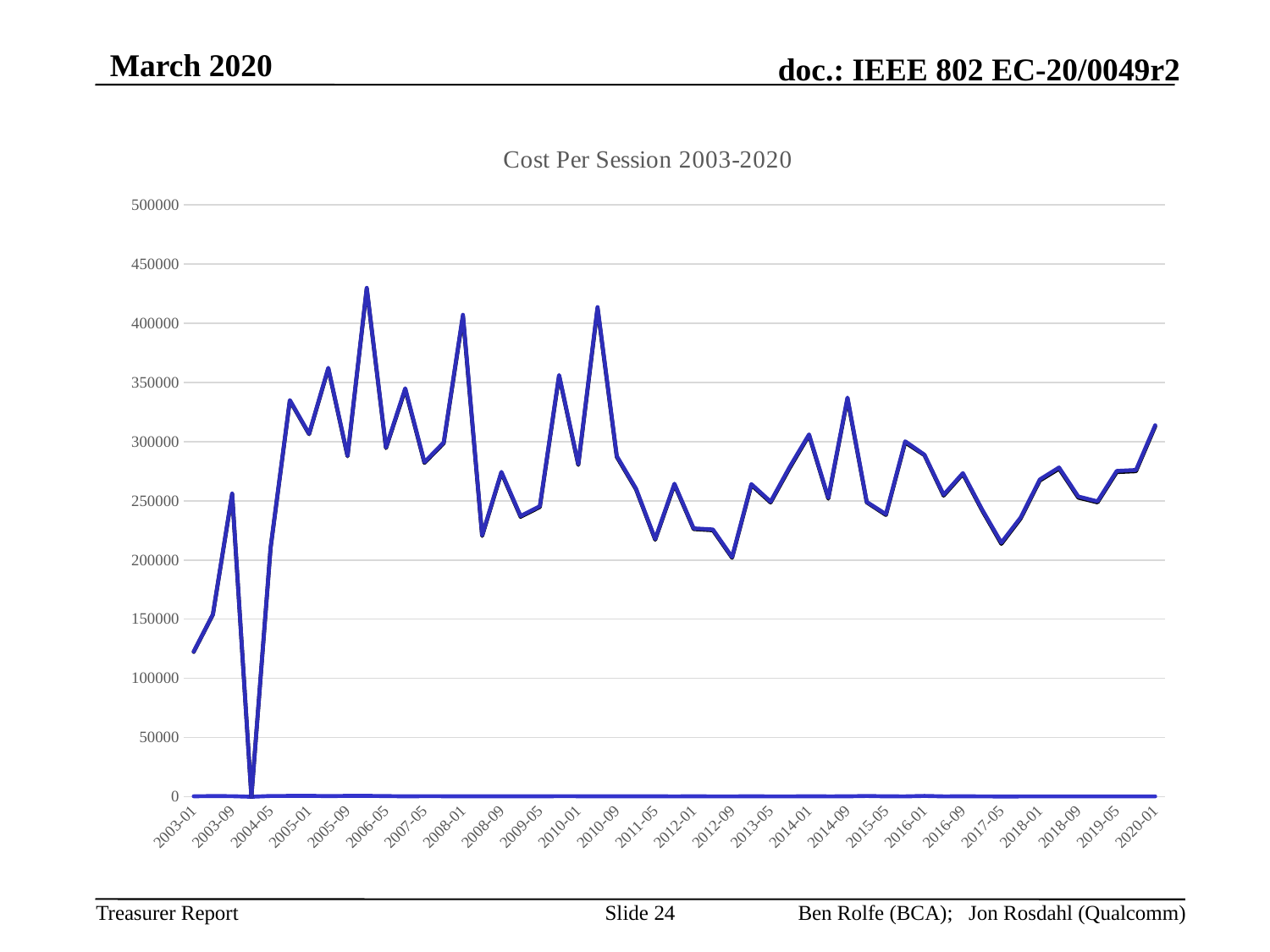
Is the value for 2011-05 greater or less than 250000? less Is the value for 2003-01 greater or less than 150000? less Is the value for 2020-01 greater or less than 300000? greater What is the highest value shown on the vertical axis? 500000 Which is larger, the value for 2003-01 or the value for 2020-01? 2020-01 What kind of chart is shown on the slide? line chart Does the cost per session rise or fall between 2014-09 and 2017-05? fall What is the title of the chart? Cost Per Session 2003-2020